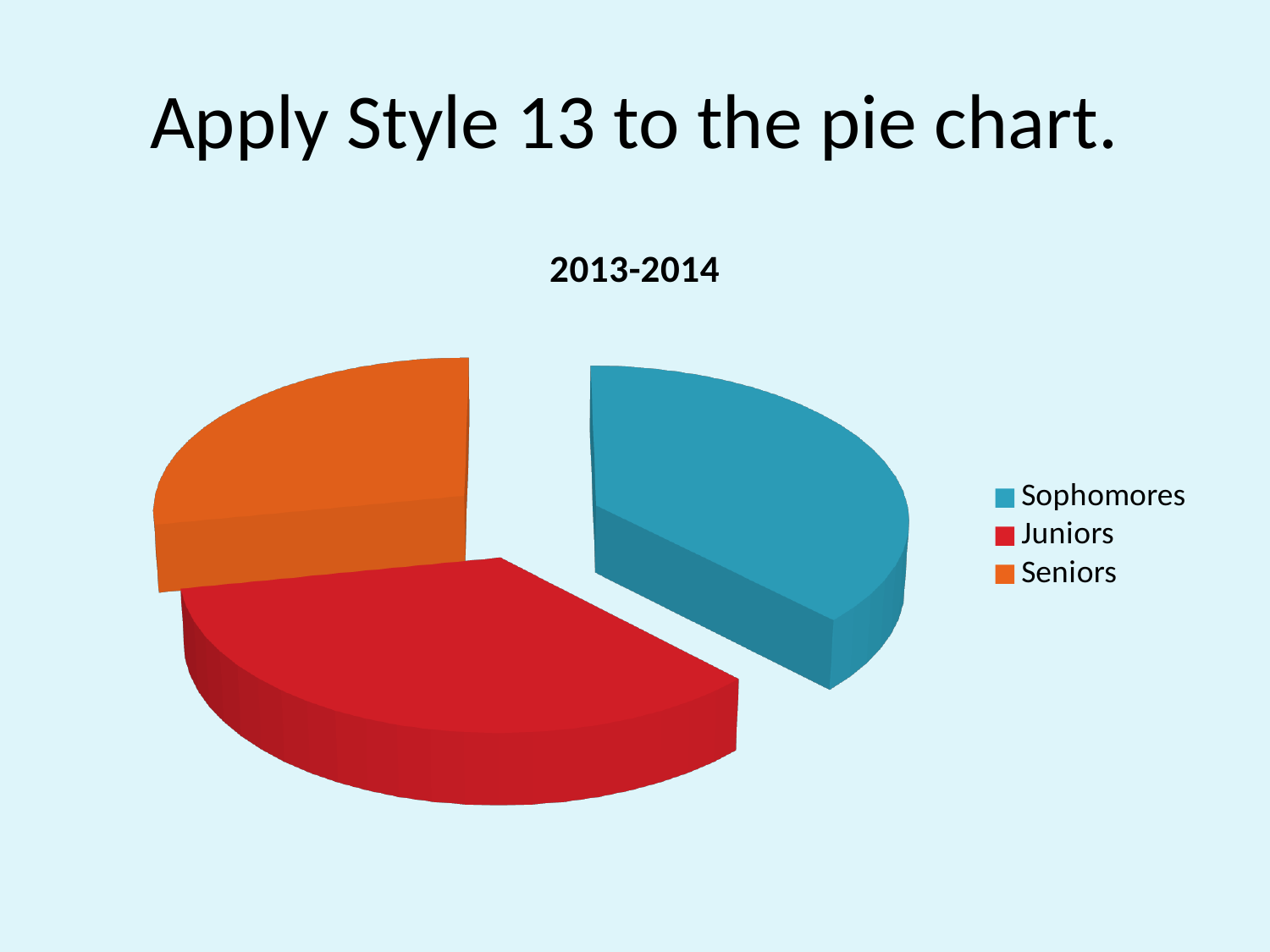
Which category has the smallest slice of the pie? Seniors Which colour represents Sophomores in the pie chart? blue What is the title of the pie chart? 2013-2014 Which slice is larger, Juniors or Seniors? Juniors How many slices does the pie chart have? 3 What kind of chart is shown on the slide? pie chart How many entries does the legend list? 3 Which category has the largest slice of the pie? Sophomores Which slice is larger, Juniors or Sophomores? Sophomores